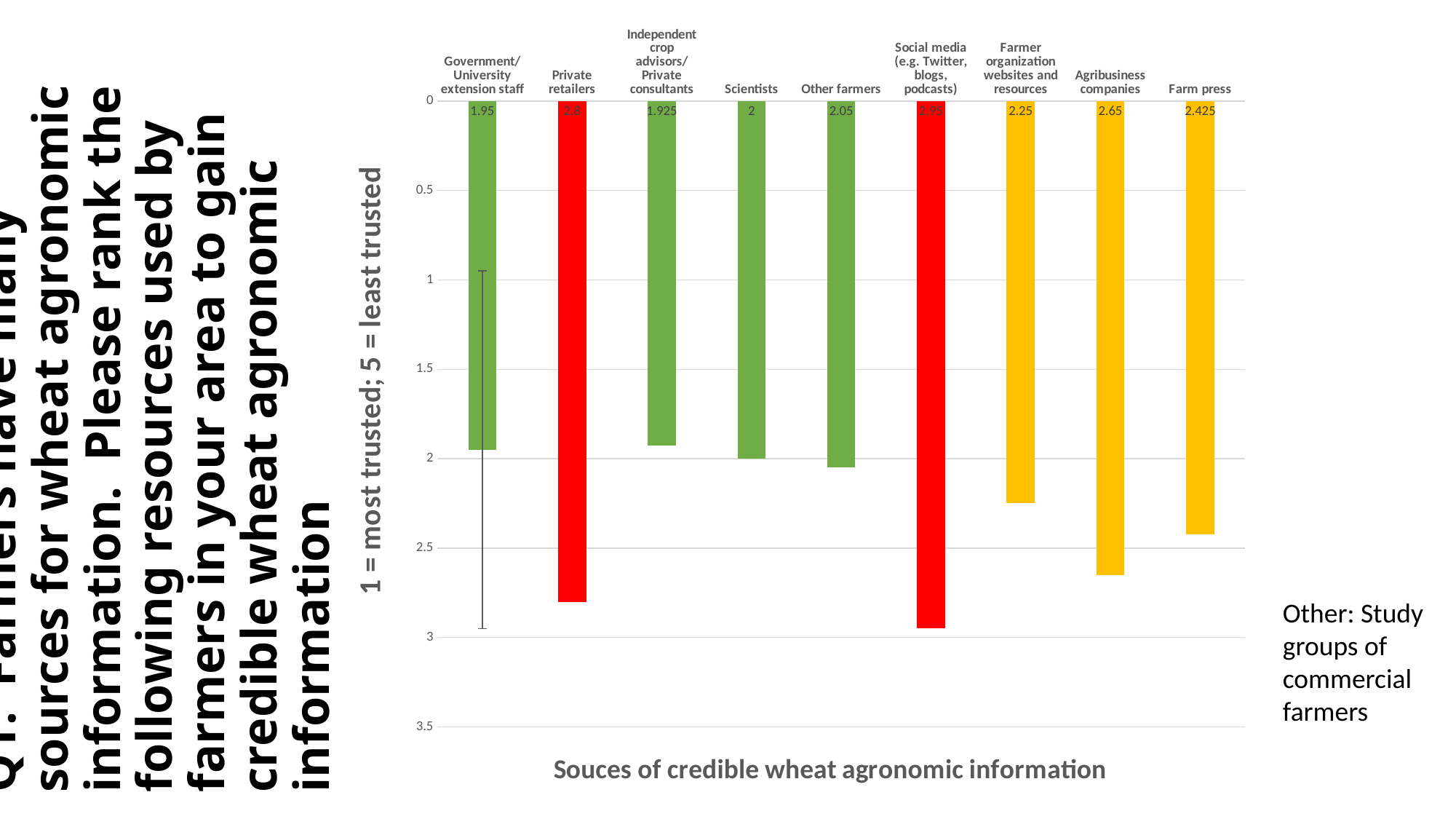
Which source has the lowest value on the chart? Independent crop advisors/Private consultants What is the difference between the values for Agribusiness companies and Farmer organization websites and resources? 0.4 Which has the larger value, Private retailers or Farm press? Private retailers What kind of chart is shown on the slide? Bar chart What is the title of the horizontal axis of the chart? Souces of credible wheat agronomic information What is the value for Social media (e.g. Twitter, blogs, podcasts)? 2.95 What is the value for Agribusiness companies? 2.65 How many sources of information are shown on the chart? 9 Which source has the highest value on the chart? Social media (e.g. Twitter, blogs, podcasts) What is the value for Farm press? 2.425 What is the value for Independent crop advisors/Private consultants? 1.925 What is the difference between the values for Social media and Private retailers? 0.15